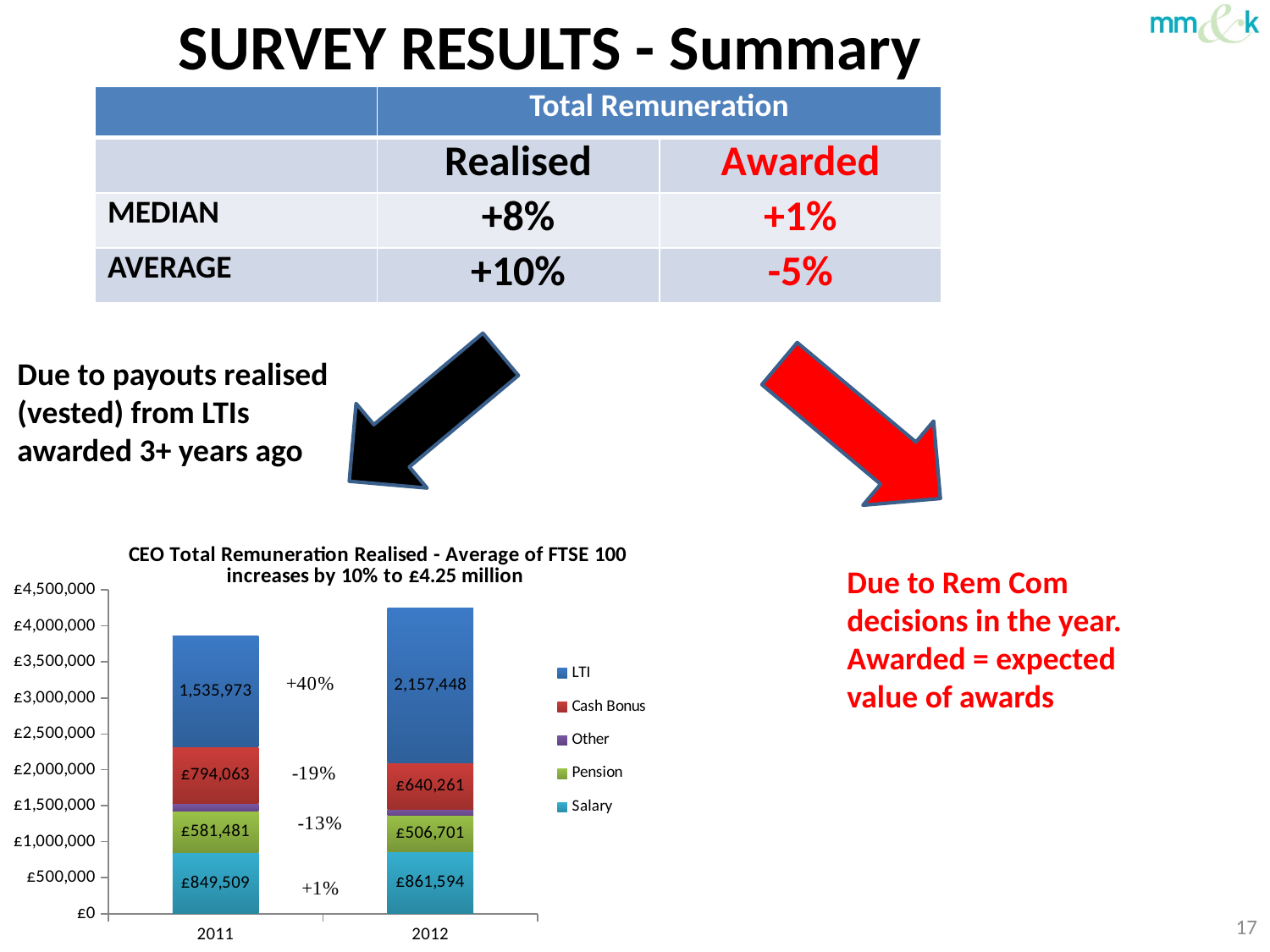
What is the Salary value for 2011? £849,509 By how much did the LTI value increase from 2011 to 2012? 621,475 Which year has the larger Cash Bonus value, 2011 or 2012? 2011 What kind of chart is shown on the slide? Stacked bar chart What percentage change is printed on the chart for the LTI component between 2011 and 2012? +40% Is the total height of the 2012 stacked bar greater or less than £4,000,000? greater What is the difference between the Salary values for 2012 and 2011? £12,085 What is the Cash Bonus value for 2012? £640,261 What is the Pension value for 2011? £581,481 How many years (categories) are shown on the x axis of the chart? 2 What is the LTI value for 2012? 2,157,448 How many series does the chart legend list? 5